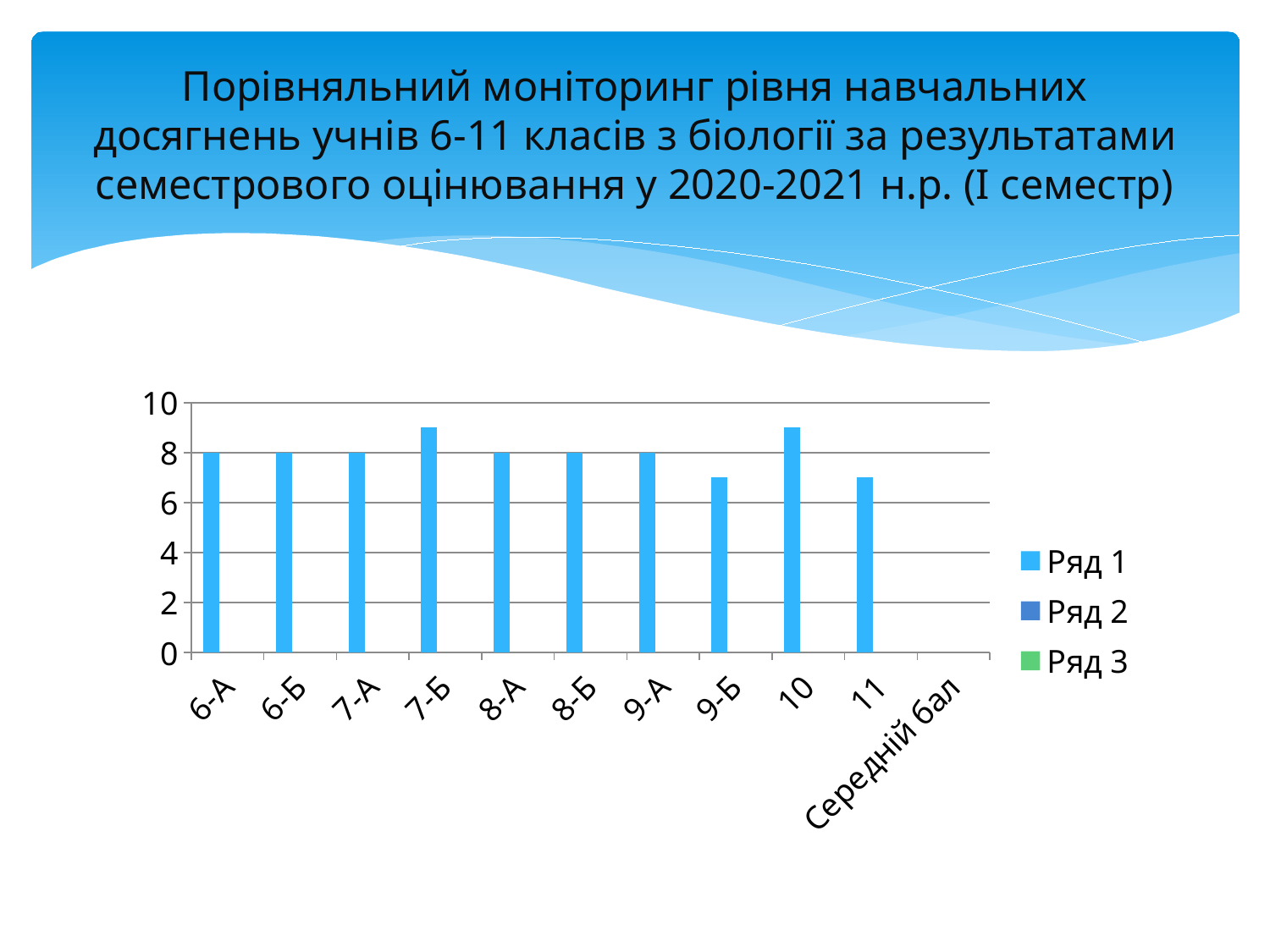
What is the value for 8-Б? 8 What kind of chart is shown on the slide? bar chart Is the value for 11 greater or less than 8? less Is the value for 10 greater or less than 8? greater How many series does the legend list? 3 Which is larger, the value for 9-Б or the value for 8-А? 8-А Which is larger, the value for 7-Б or the value for 7-А? 7-Б What is the value for 9-А? 8 What is the value for 6-А? 8 Is the value for 7-Б greater or less than 8? greater How many categories are shown on the x axis? 11